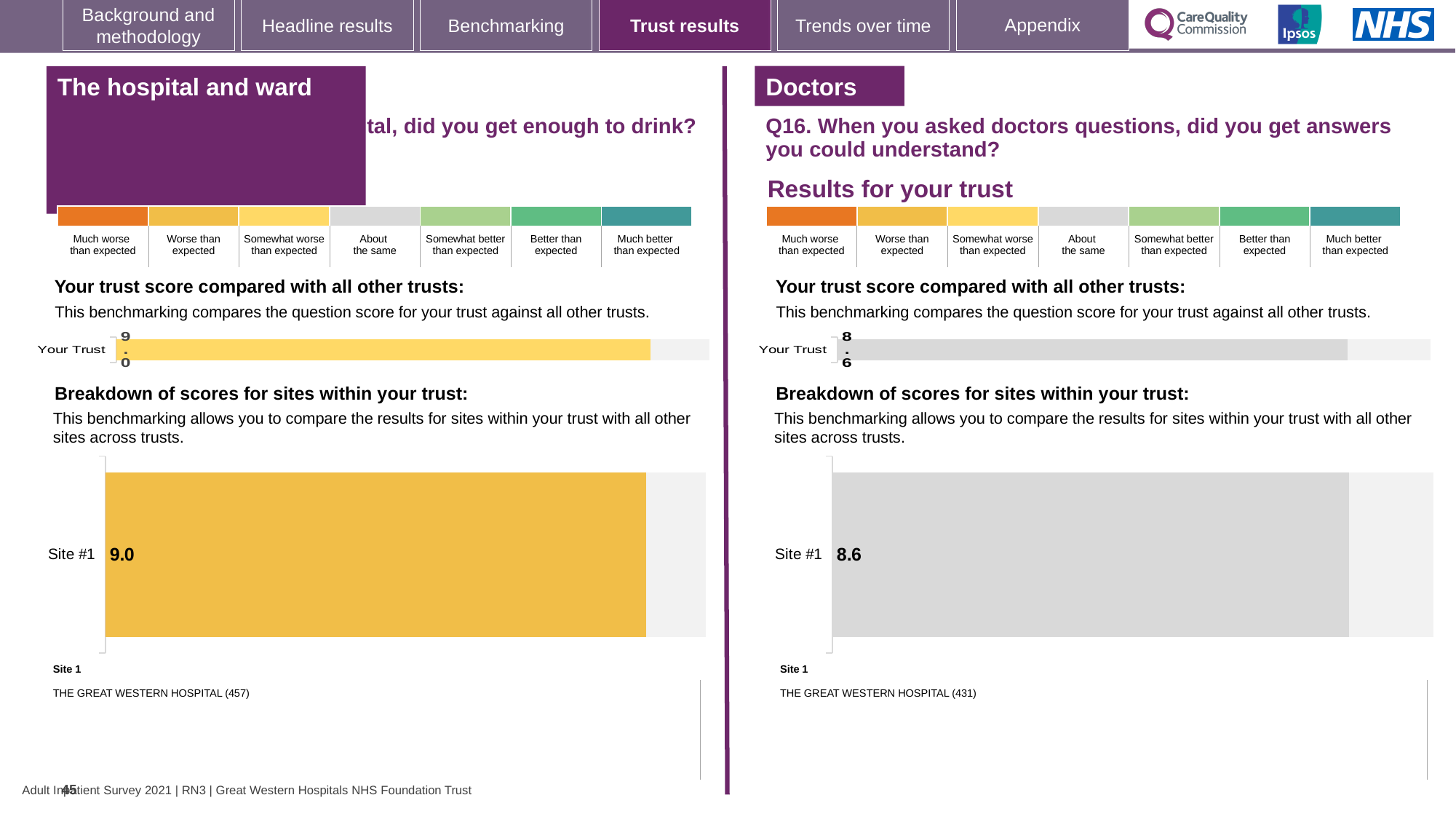
What is the difference between the Site #1 score on the left-hand breakdown chart and the Site #1 score on the right-hand breakdown chart? 0.4 What colour is the Site #1 bar on the right-hand breakdown chart (Doctors, Q16)? Grey Which site name is listed as Site 1 beneath the left-hand breakdown chart? THE GREAT WESTERN HOSPITAL (457) How many sites are shown on the right-hand 'Breakdown of scores for sites within your trust' chart (Q16)? 1 What type of chart is used to show the Your Trust score on the right-hand side (Doctors, Q16)? Bar chart On the left-hand 'Your trust score compared with all other trusts' chart (The hospital and ward section), what is the value shown for Your Trust? 9.0 How many sites are shown on the left-hand 'Breakdown of scores for sites within your trust' chart? 1 On the left-hand 'Breakdown of scores for sites within your trust' chart, what is the score for Site #1? 9.0 Which is larger: the Your Trust score on the left-hand chart (The hospital and ward) or the Your Trust score on the right-hand chart (Doctors, Q16)? The left-hand chart (9.0) On the right-hand 'Breakdown of scores for sites within your trust' chart (Q16), what is the score for Site #1? 8.6 What type of chart is used for the 'Breakdown of scores for sites within your trust' on the left-hand side? Bar chart On the right-hand 'Your trust score compared with all other trusts' chart (Doctors, Q16), what is the value shown for Your Trust? 8.6